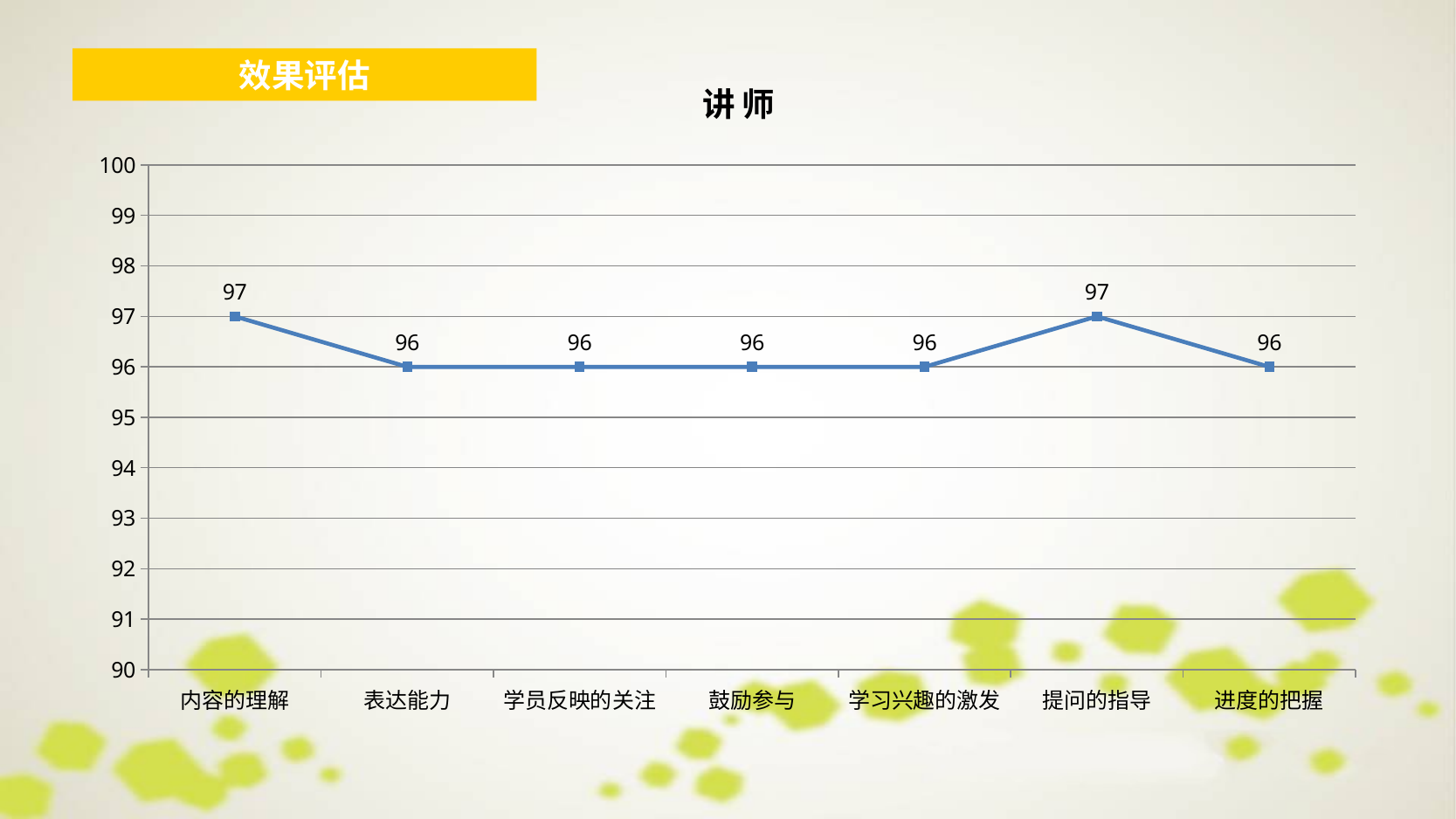
Is the value for 学员反映的关注 greater or less than 95? greater Which is larger, the value for 提问的指导 or the value for 学习兴趣的激发? 提问的指导 What kind of chart is shown on the slide? line chart What is the title of the chart? 讲师 What is the value for 进度的把握? 96 What is the value for 提问的指导? 97 What is the value for 内容的理解? 97 What is the value for 表达能力? 96 What is the difference between the values for 内容的理解 and 表达能力? 1 How many categories are shown on the x axis? 7 What is the value for 鼓励参与? 96 Does the value rise or fall from 内容的理解 to 表达能力? fall